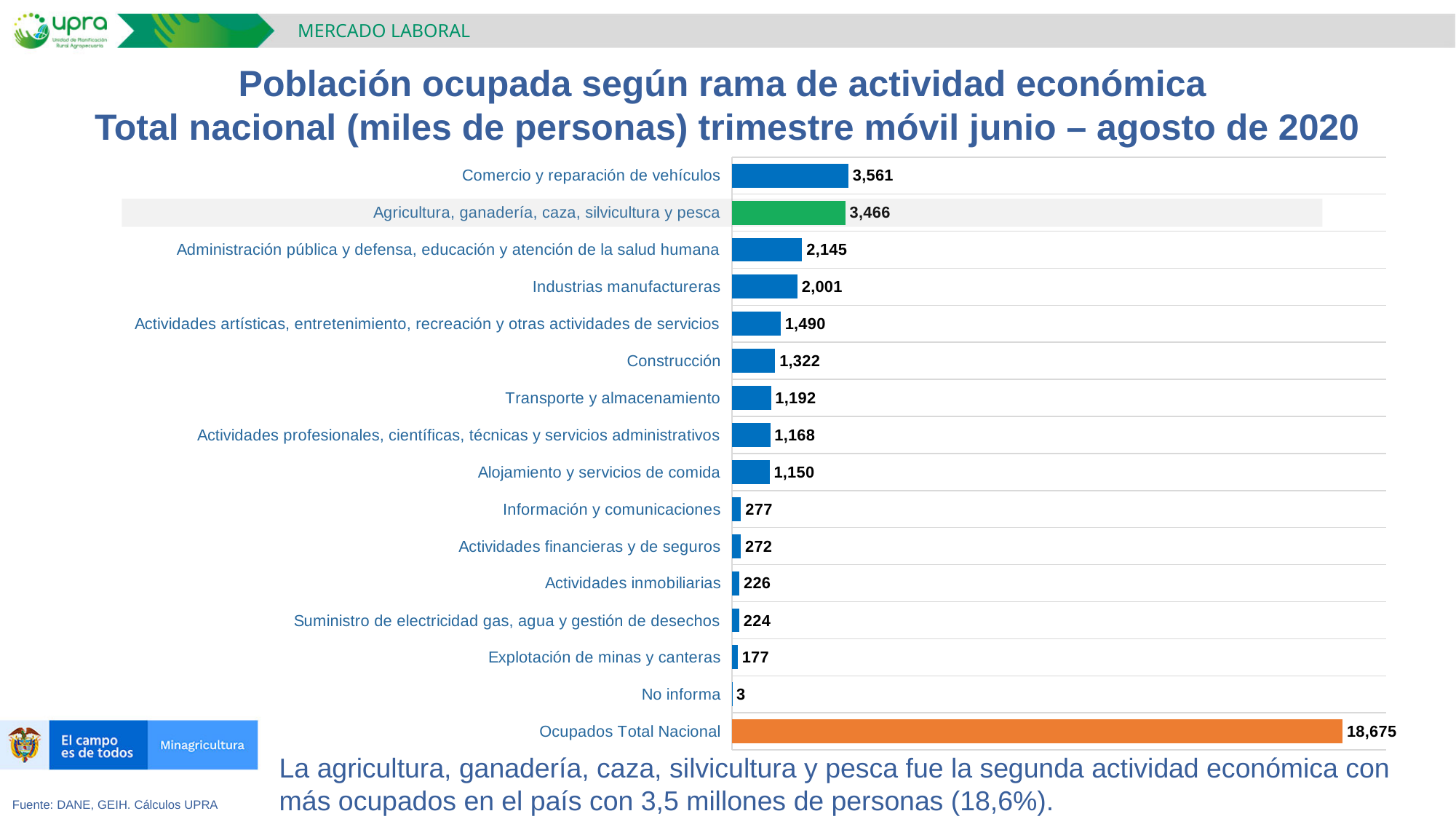
Which category has the lowest value? No informa Excluding the Ocupados Total Nacional bar, which economic activity has the highest value? Comercio y reparación de vehículos What is the value for Construcción? 1,322 What is the difference between the values for Comercio y reparación de vehículos and Agricultura, ganadería, caza, silvicultura y pesca? 95 What colour is the bar for Agricultura, ganadería, caza, silvicultura y pesca? Green What is the value for Agricultura, ganadería, caza, silvicultura y pesca? 3,466 What kind of chart is shown on the slide? Bar chart What is the value for Ocupados Total Nacional? 18,675 What is the difference between the values for Administración pública y defensa, educación y atención de la salud humana and Industrias manufactureras? 144 Which is larger, the value for Transporte y almacenamiento or the value for Alojamiento y servicios de comida? Transporte y almacenamiento What is the value for Explotación de minas y canteras? 177 How many categories (bars) are shown in the chart? 16